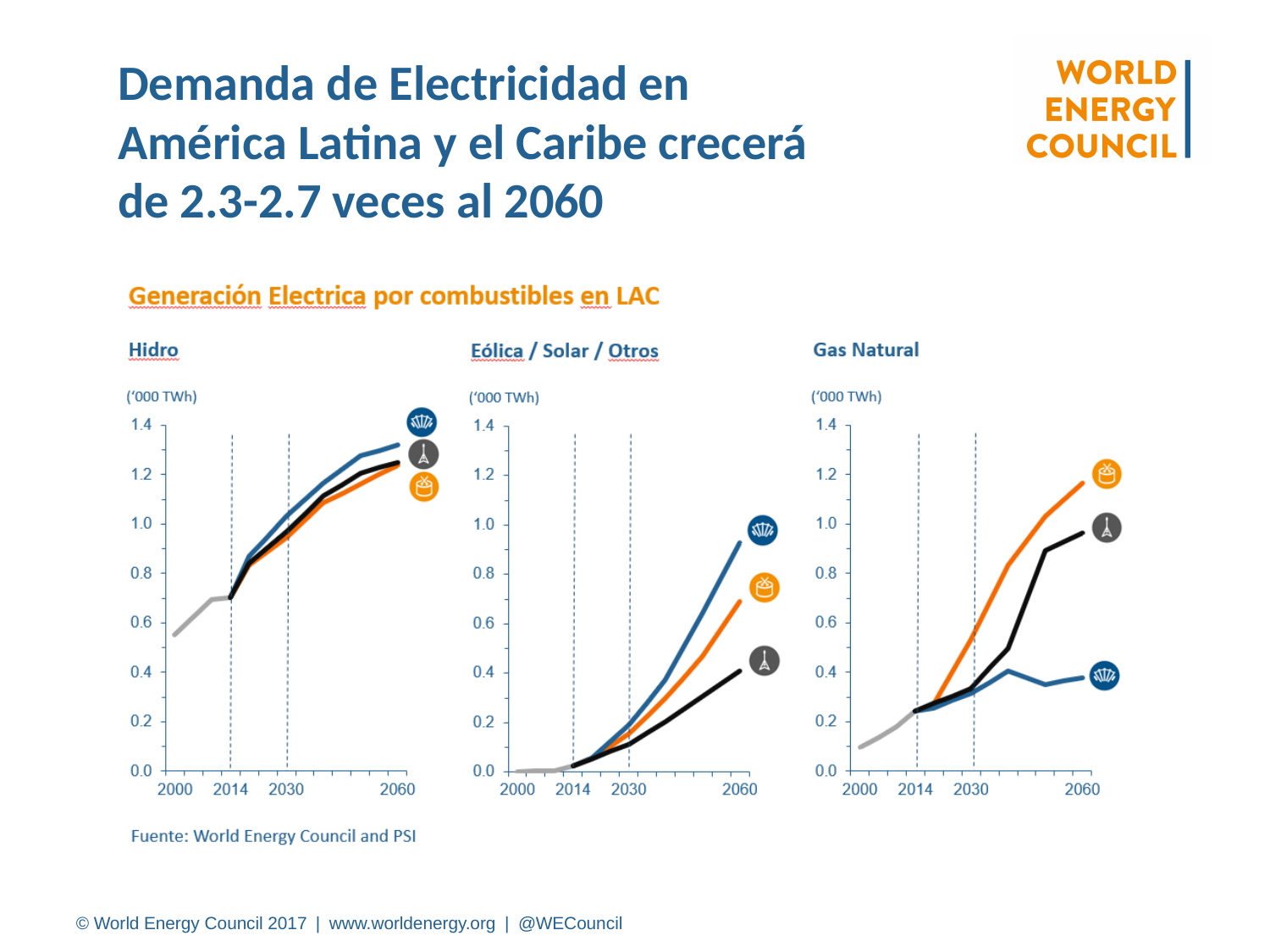
What source is cited below the charts? World Energy Council and PSI In the Hidro chart, do the values rise or fall from 2000 to 2060? rise In the Gas Natural chart, is the blue line's value in 2060 greater or less than 0.6? less In the Eólica / Solar / Otros chart, is the value in 2000 greater or less than 0.2? less In the Hidro chart, is the blue line's value in 2060 greater or less than 1.2? greater In the Gas Natural chart, which line is higher in 2060, the orange line or the blue line? orange line How many separate charts are shown under the heading 'Generación Electrica por combustibles en LAC'? 3 What type of chart is used for the Hidro panel? line chart What unit is shown on the y axis of the Gas Natural chart? '000 TWh